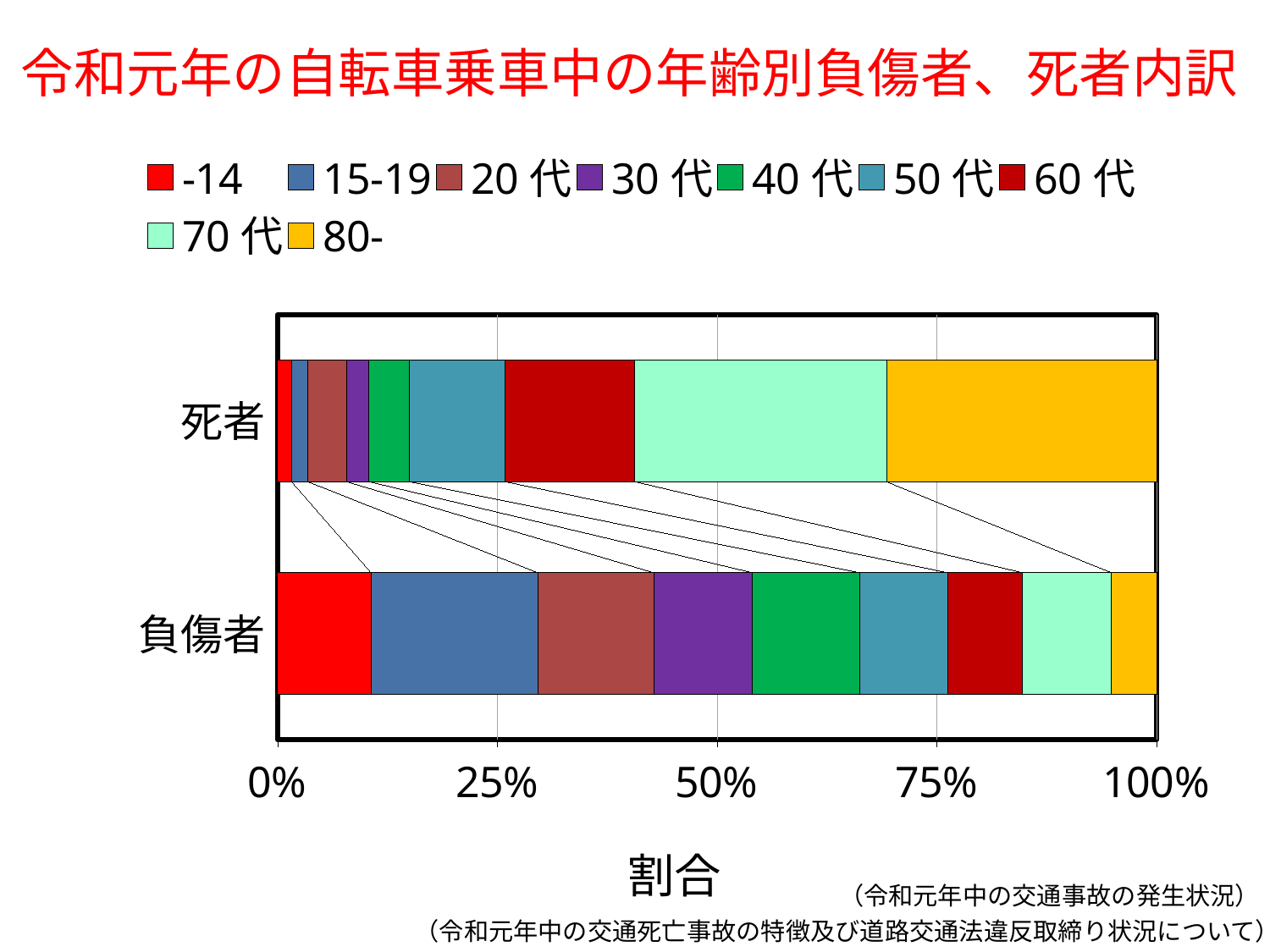
How many categories (bars) does the chart show? 2 What kind of chart is shown on the slide? stacked bar chart Is the share of the -14 group in the 負傷者 bar greater or less than 25%? less Is the share of the 80- group in the 死者 bar greater or less than 25%? greater Which bar has the larger share for the -14 age group, 死者 or 負傷者? 負傷者 How many series does the legend list? 9 What is the label on the horizontal axis? 割合 Which age group has the largest share in the 負傷者 bar? 15-19 Which age group has the smallest share in the 負傷者 bar? 80- Which bar has the larger share for the 80- age group, 死者 or 負傷者? 死者 What is the title of the chart? 令和元年の自転車乗車中の年齢別負傷者、死者内訳